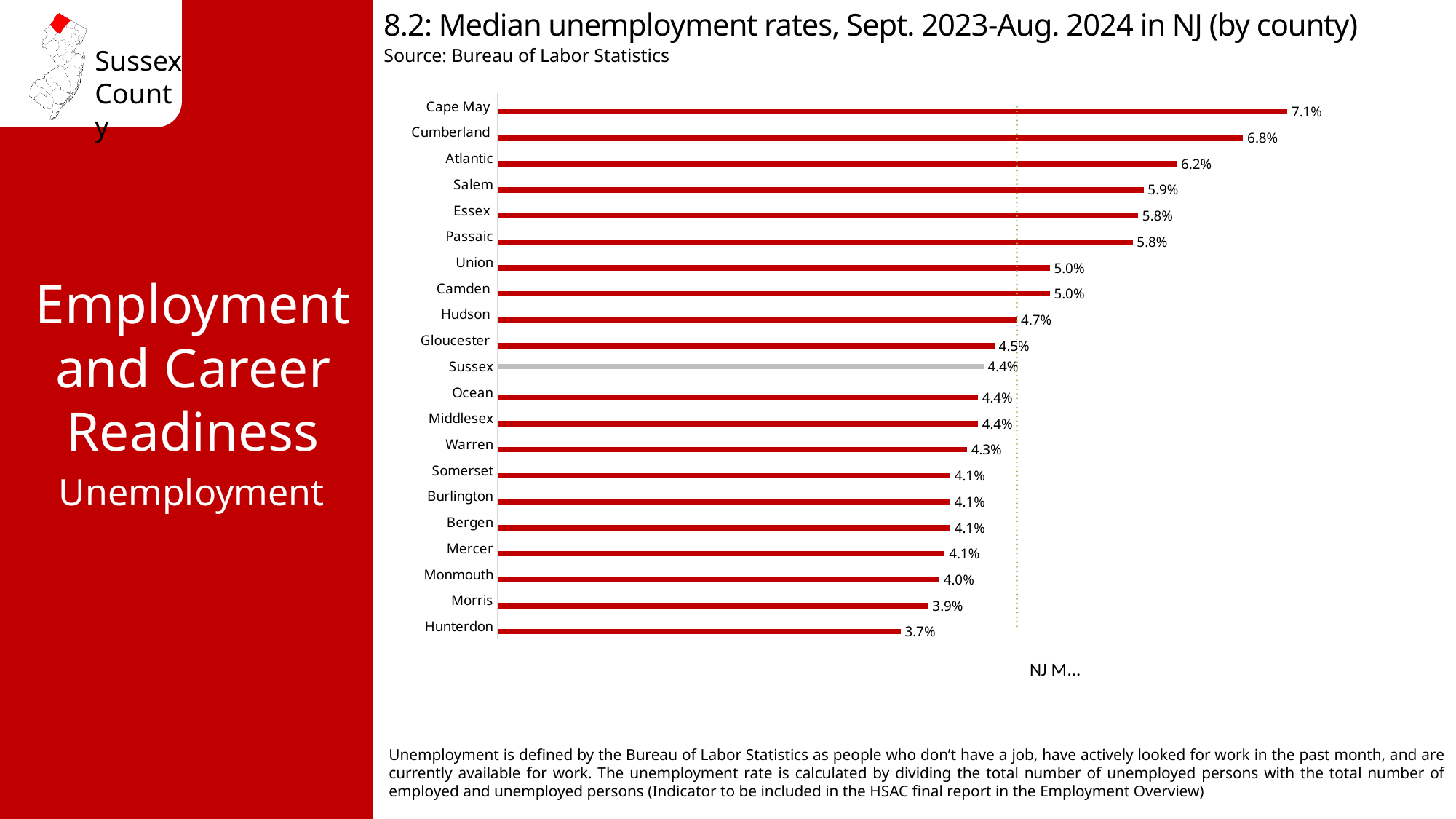
What is the median unemployment rate for Hunterdon? 3.7% Which county's bar is shown in gray rather than red? Sussex What is the median unemployment rate for Sussex? 4.4% What is the median unemployment rate for Cape May? 7.1% Which county has the highest median unemployment rate? Cape May Which county has the lowest median unemployment rate? Hunterdon What is the difference between the median unemployment rates of Cumberland and Sussex? 2.4% What is the difference between the median unemployment rates of Cape May and Hunterdon? 3.4% How many counties are shown in the chart? 21 Which county has a higher median unemployment rate, Atlantic or Union? Atlantic What kind of chart is shown on the slide? Bar chart What is the median unemployment rate for Morris? 3.9%